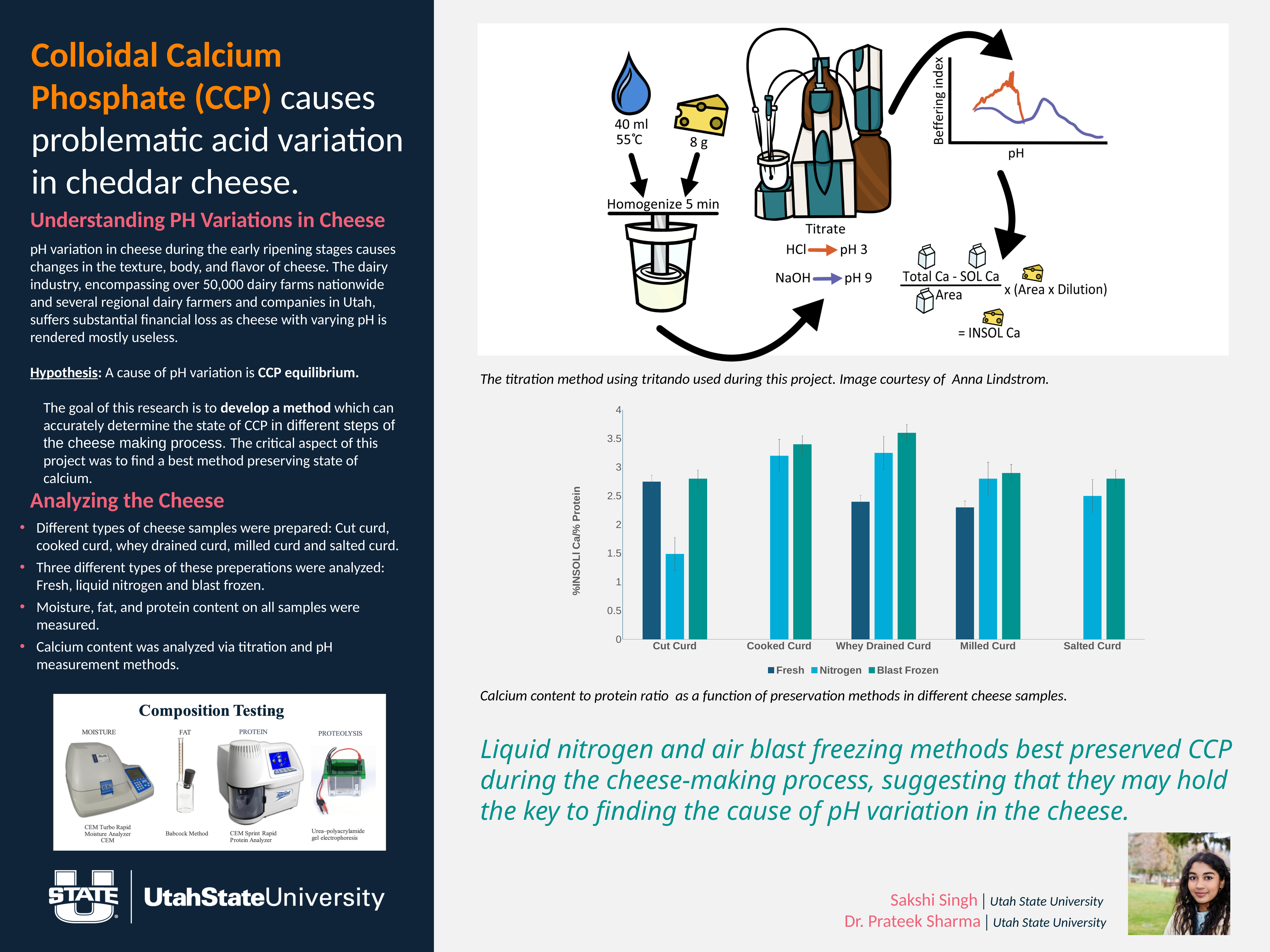
Is the Nitrogen value for Cut Curd greater or less than 2? less What are the series names listed in the chart's legend? Fresh, Nitrogen, Blast Frozen For which cheese sample is the Nitrogen value lowest? Cut Curd Is the Blast Frozen value for Whey Drained Curd greater or less than 3? greater How many series does the chart's legend list? 3 Is the Fresh value for Milled Curd greater or less than 2.5? less How many cheese sample categories are shown on the x axis of the chart? 5 For Cut Curd, which is larger: the Fresh value or the Nitrogen value? Fresh What kind of chart is shown on the slide? bar chart For which cheese sample is the Fresh value highest? Cut Curd What is the label on the chart's y axis? %INSOL Ca/% Protein